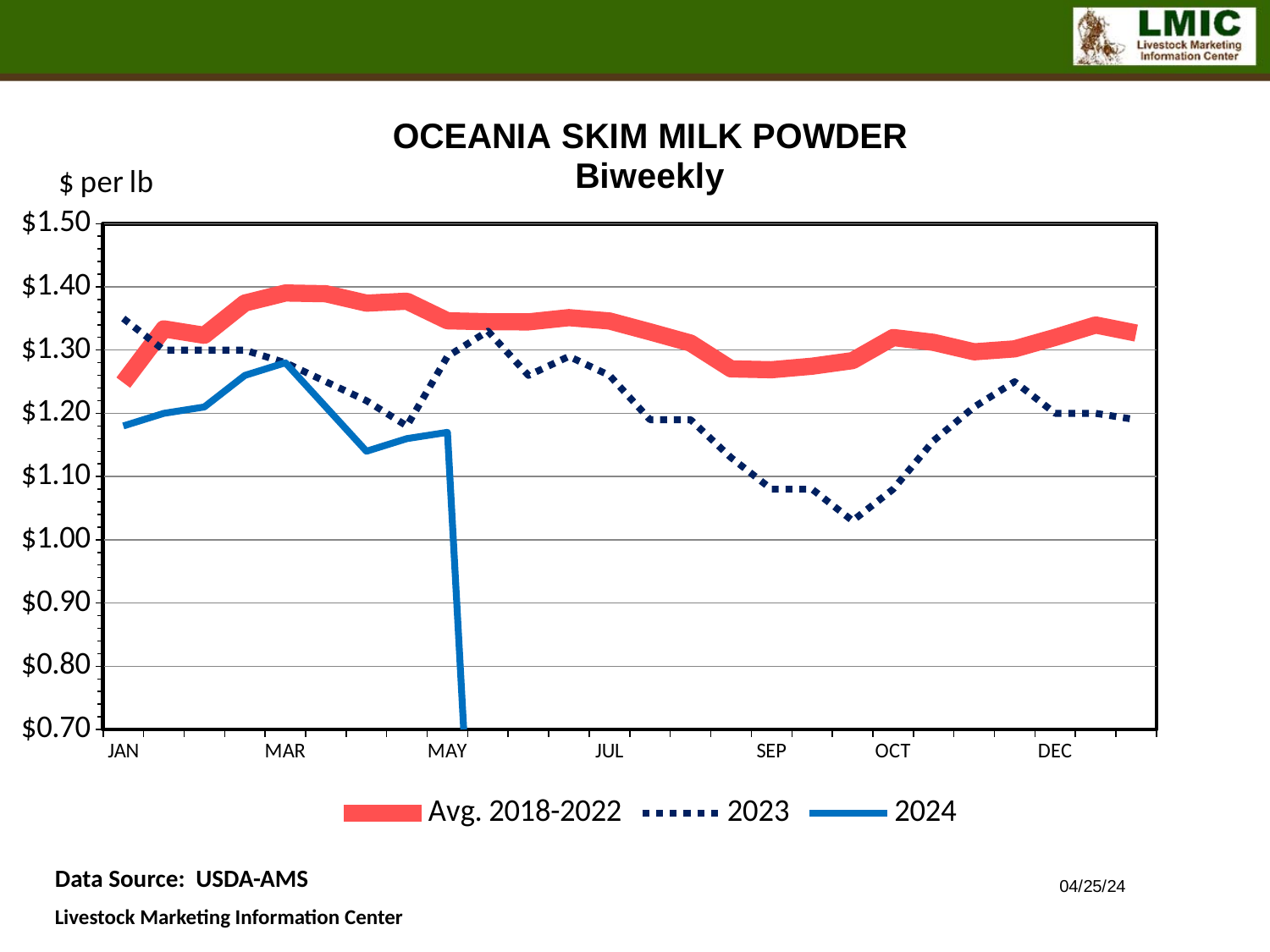
Does the Avg. 2018-2022 series rise or fall from JAN to MAR? rise In SEP, which series has the higher value: Avg. 2018-2022 or 2023? Avg. 2018-2022 Does the 2023 series rise or fall from JUL to SEP? fall What kind of chart is shown on the slide? line chart Is the value of the 2024 series in JAN greater or less than $1.30? less What is the title of the chart? OCEANIA SKIM MILK POWDER Biweekly Is the lowest value of the 2023 series, reached between SEP and OCT, greater or less than $1.10? less In JAN, which series has the higher value: 2023 or 2024? 2023 Is the value of the Avg. 2018-2022 series in MAR greater or less than $1.30? greater What unit is shown on the y axis of the chart? $ per lb How many series does the legend list? 3